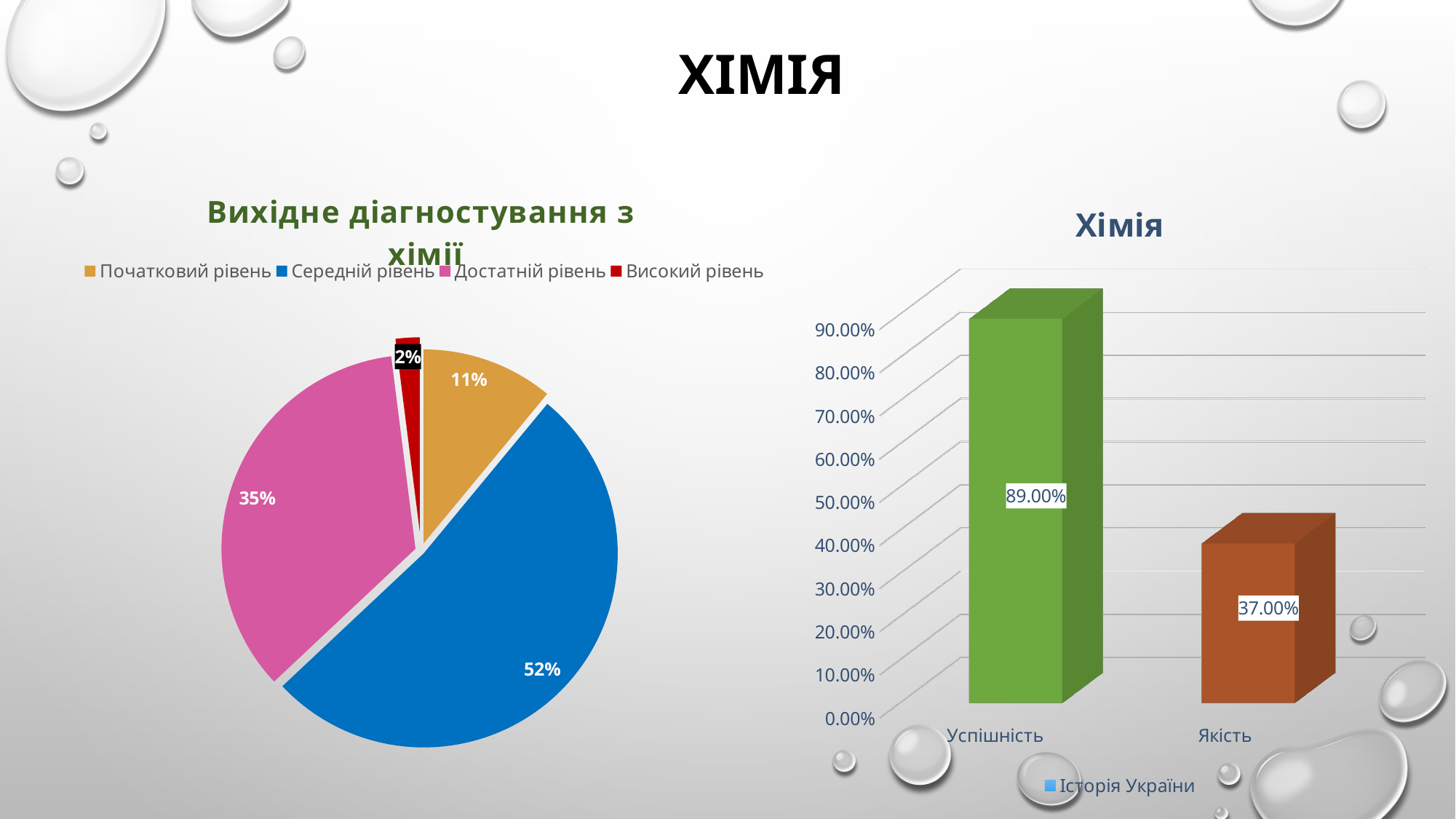
What kind of chart is the chart titled 'Хімія' on the right? Bar chart In the chart titled 'Хімія' on the right, what is the value for 'Якість'? 37.00% In the pie chart 'Вихідне діагностування з хімії', what is the difference between the shares of 'Достатній рівень' and 'Початковий рівень'? 24% In the pie chart 'Вихідне діагностування з хімії', what share does 'Середній рівень' have? 52% In the chart titled 'Хімія' on the right, what is the value for 'Успішність'? 89.00% In the pie chart 'Вихідне діагностування з хімії', which level has the largest share? Середній рівень In the pie chart 'Вихідне діагностування з хімії', which is larger: 'Початковий рівень' or 'Достатній рівень'? Достатній рівень In the pie chart 'Вихідне діагностування з хімії', which level has the smallest share? Високий рівень In the chart titled 'Хімія' on the right, what is the difference between 'Успішність' and 'Якість'? 52.00% In the pie chart 'Вихідне діагностування з хімії', what share does 'Високий рівень' have? 2% In the pie chart 'Вихідне діагностування з хімії', how many slices are there? 4 What series name does the legend of the chart titled 'Хімія' on the right show? Історія України